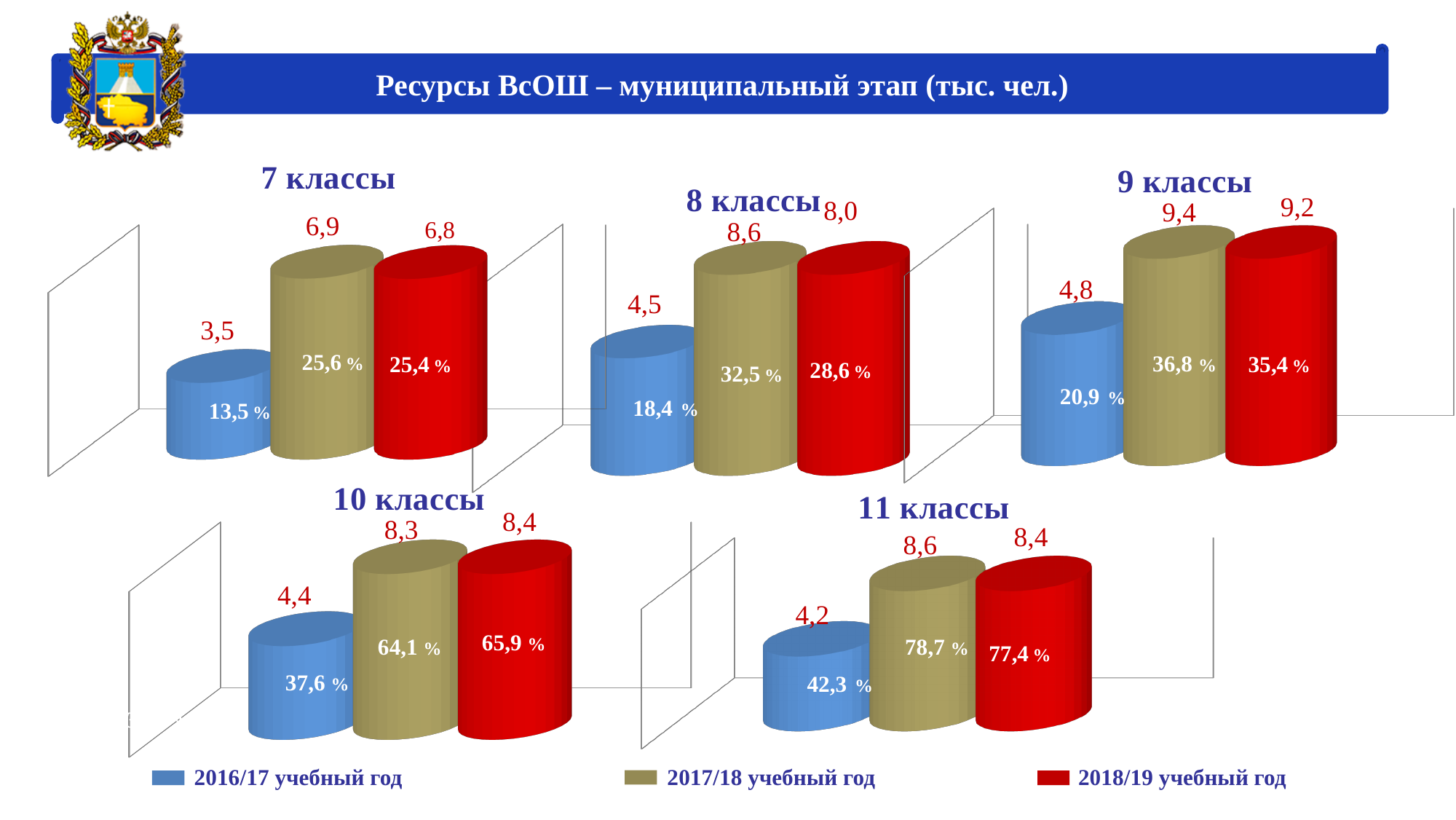
In the "9 классы" chart, which year has the highest value? 2017/18 учебный год In the "11 классы" chart, what is the value for 2018/19 учебный год? 8,4 How many series does the legend at the bottom of the slide list? 3 In the "7 классы" chart, which is larger: the value for 2017/18 учебный год or for 2016/17 учебный год? 2017/18 учебный год In the "7 классы" chart, what is the value for 2016/17 учебный год? 3,5 Which colour represents 2018/19 учебный год in the legend? red In the "9 классы" chart, what percentage is printed inside the 2018/19 учебный год bar? 35,4 % How many bars are shown in the "11 классы" chart? 3 In the "8 классы" chart, what is the value for 2017/18 учебный год? 8,6 What kind of chart is the "10 классы" chart? bar chart In the "10 классы" chart, which year has the lowest value? 2016/17 учебный год In the "8 классы" chart, what is the difference between the 2017/18 and 2016/17 values? 4,1